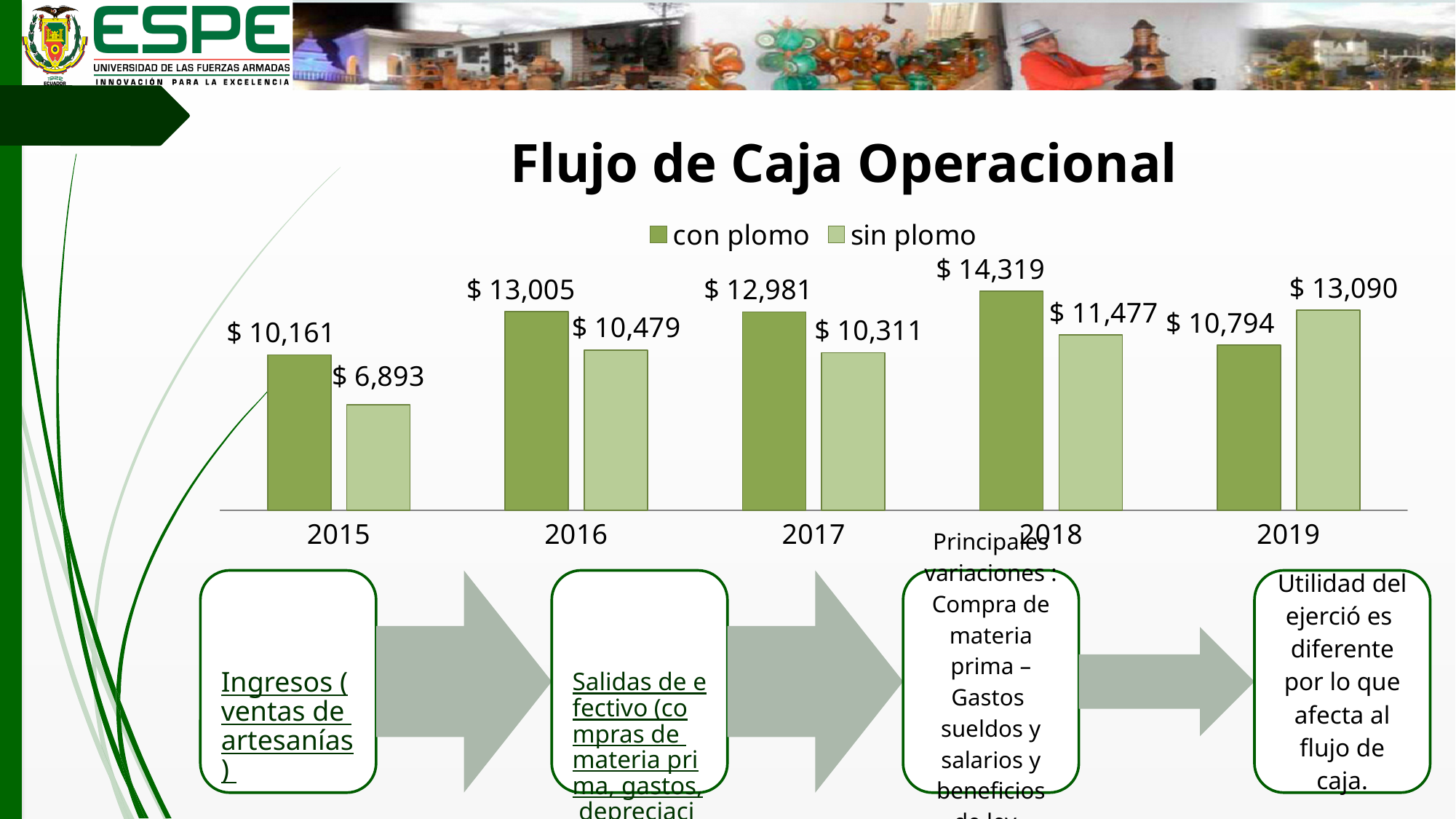
How many years are shown on the x axis? 5 What is the value for 'con plomo' in 2015? $ 10,161 What kind of chart is shown on the slide? bar chart What is the difference between 'sin plomo' and 'con plomo' in 2019? $ 2,296 In which year is the 'sin plomo' value lowest? 2015 What is the value for 'sin plomo' in 2017? $ 10,311 In 2019, which series has the larger value, 'con plomo' or 'sin plomo'? sin plomo How many series does the legend list? 2 In which year is the 'sin plomo' value highest? 2019 What is the difference between 'con plomo' and 'sin plomo' in 2015? $ 3,268 What is the value for 'sin plomo' in 2019? $ 13,090 In which year is the 'con plomo' value highest? 2018